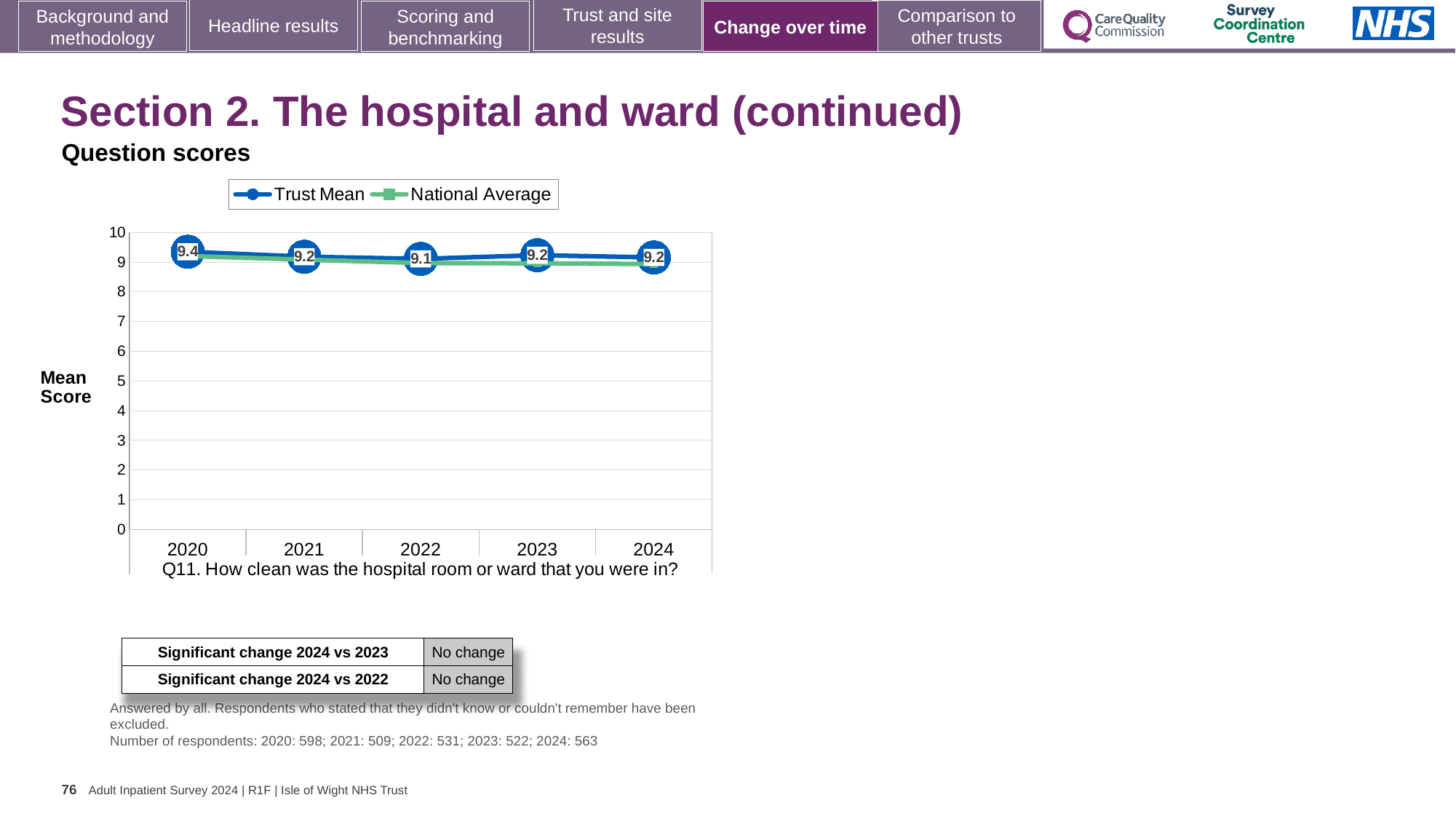
Which is larger, the Trust Mean for 2020 or for 2021? 2020 In which year is the Trust Mean lowest? 2022 How many series does the legend list? 2 How many years are shown on the x axis? 5 Does the Trust Mean rise or fall from 2020 to 2022? Fall What kind of chart is shown? Line chart What is the Trust Mean value for 2024? 9.2 What is the difference between the Trust Mean in 2020 and in 2022? 0.3 What is the Trust Mean value for 2022? 9.1 Is the National Average value for 2024 greater or less than 8? greater In which year is the Trust Mean highest? 2020 What is the Trust Mean value for 2020? 9.4